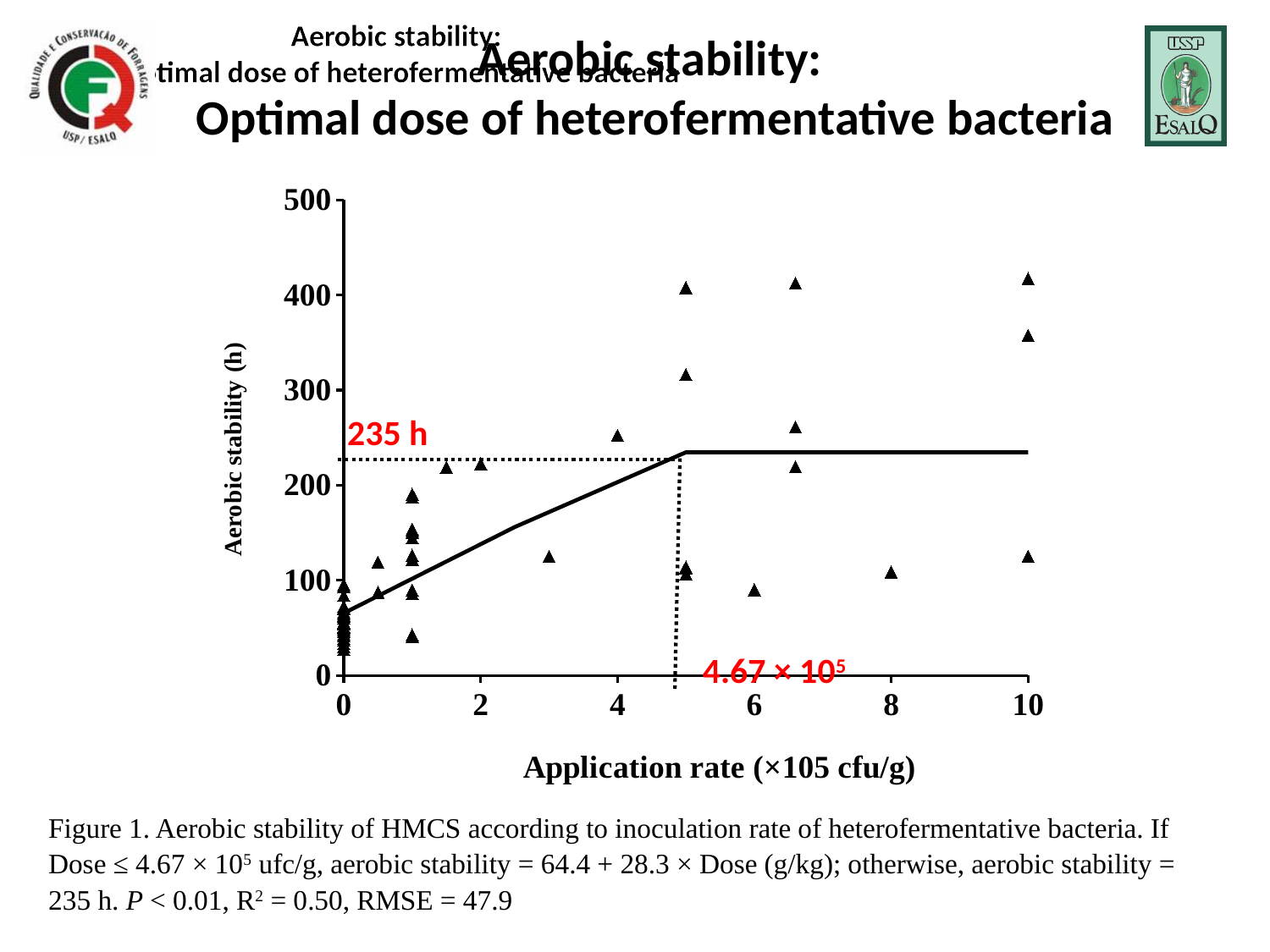
What is the maximum value shown on the y axis? 500 Is the data point at an application rate of 3 greater or less than 100? greater What kind of chart is shown on the slide? Scatter plot What aerobic stability value does the fitted line plateau at, as labelled on the chart? 235 h What is the label of the y axis of the chart? Aerobic stability (h) Is the data point at an application rate of 6 greater or less than 100? less Is the plateau value of the fitted line greater or less than 200? greater How does the fitted line behave as the application rate increases from 0 to 10? It rises until 4.67 × 10^5, then stays flat At what application rate does the fitted line reach its plateau, as labelled on the chart? 4.67 × 10^5 At which application rate is the lowest aerobic stability data point observed? 0 What is the label of the x axis of the chart? Application rate (×105 cfu/g)